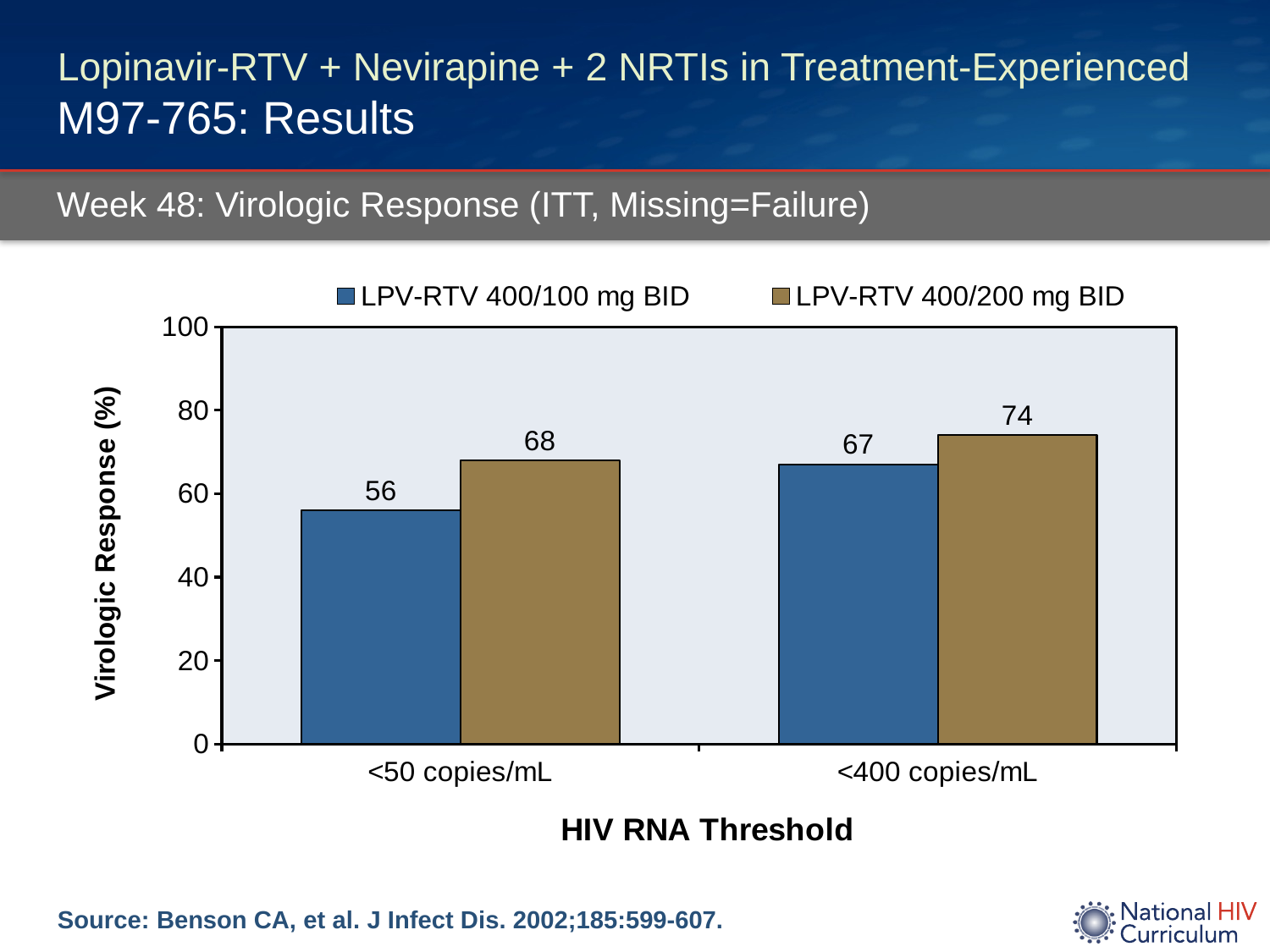
At the <400 copies/mL threshold, which regimen has the higher virologic response? LPV-RTV 400/200 mg BID What is the difference in virologic response between the two regimens at the <50 copies/mL threshold? 12 What is the difference in virologic response between the two regimens at the <400 copies/mL threshold? 7 Which bar has the highest virologic response on the chart? LPV-RTV 400/200 mg BID at <400 copies/mL Which bar has the lowest virologic response on the chart? LPV-RTV 400/100 mg BID at <50 copies/mL What is the virologic response for LPV-RTV 400/200 mg BID at the <50 copies/mL threshold? 68 How many HIV RNA threshold categories are shown on the x axis? 2 How many series does the legend list? 2 What is the virologic response for LPV-RTV 400/100 mg BID at the <400 copies/mL threshold? 67 What kind of chart is shown on the slide? Bar chart What is the virologic response for LPV-RTV 400/200 mg BID at the <400 copies/mL threshold? 74 What is the virologic response for LPV-RTV 400/100 mg BID at the <50 copies/mL threshold? 56